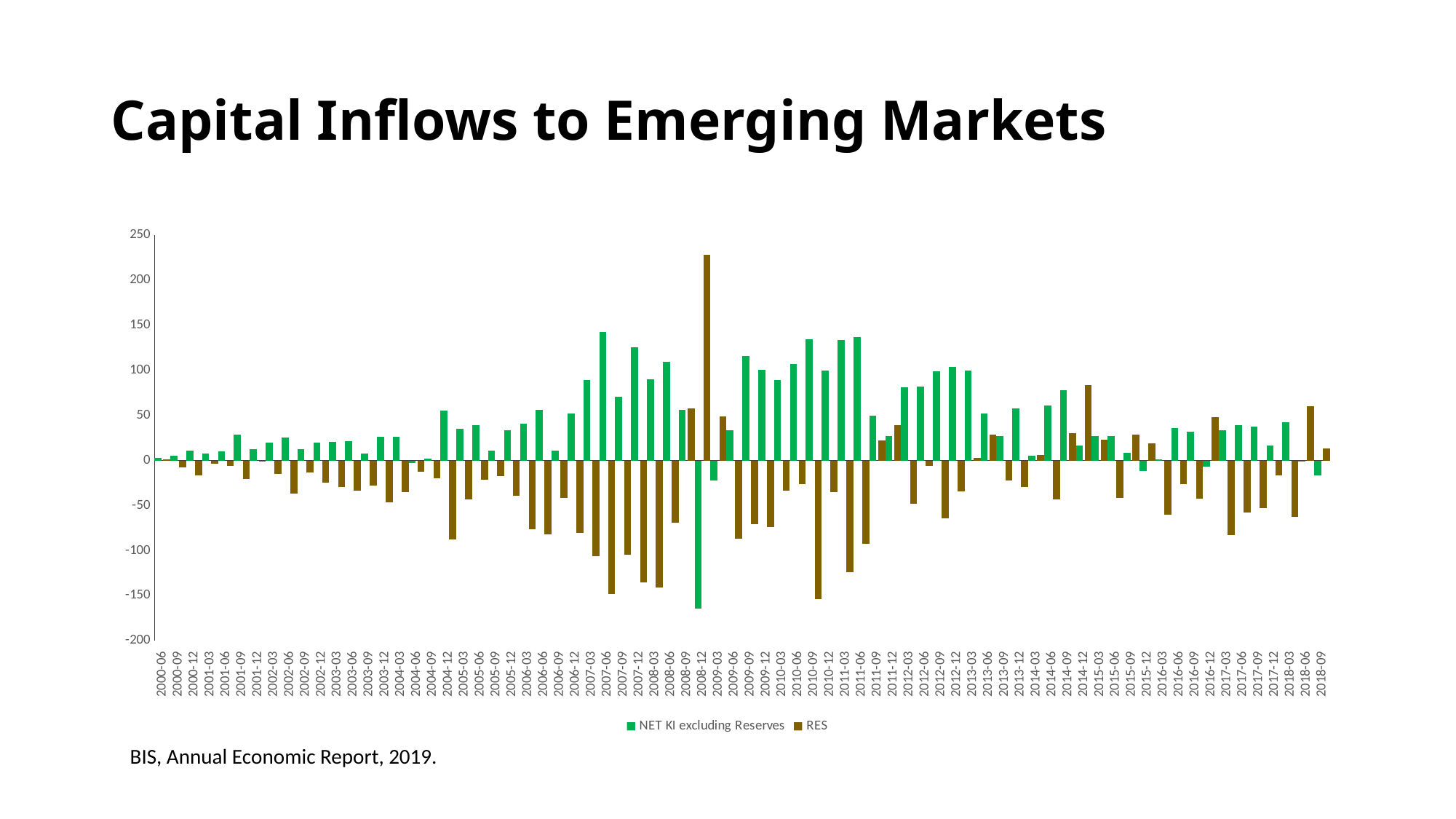
Is the NET KI excluding Reserves value for 2008-12 greater or less than -150? less Is the RES value for 2008-12 greater or less than 200? greater Which is larger: the NET KI excluding Reserves value for 2007-06 or for 2004-12? 2007-06 In which period does the RES series reach its highest value? 2008-12 In which period does the NET KI excluding Reserves series reach its lowest value? 2008-12 What kind of chart is shown on the slide? bar chart Which is larger: the RES value for 2008-12 or for 2014-12? 2008-12 What are the two series named in the legend? NET KI excluding Reserves and RES Is the RES value for 2007-06 greater or less than -100? less What is the title of the chart? Capital Inflows to Emerging Markets How many series does the legend list? 2